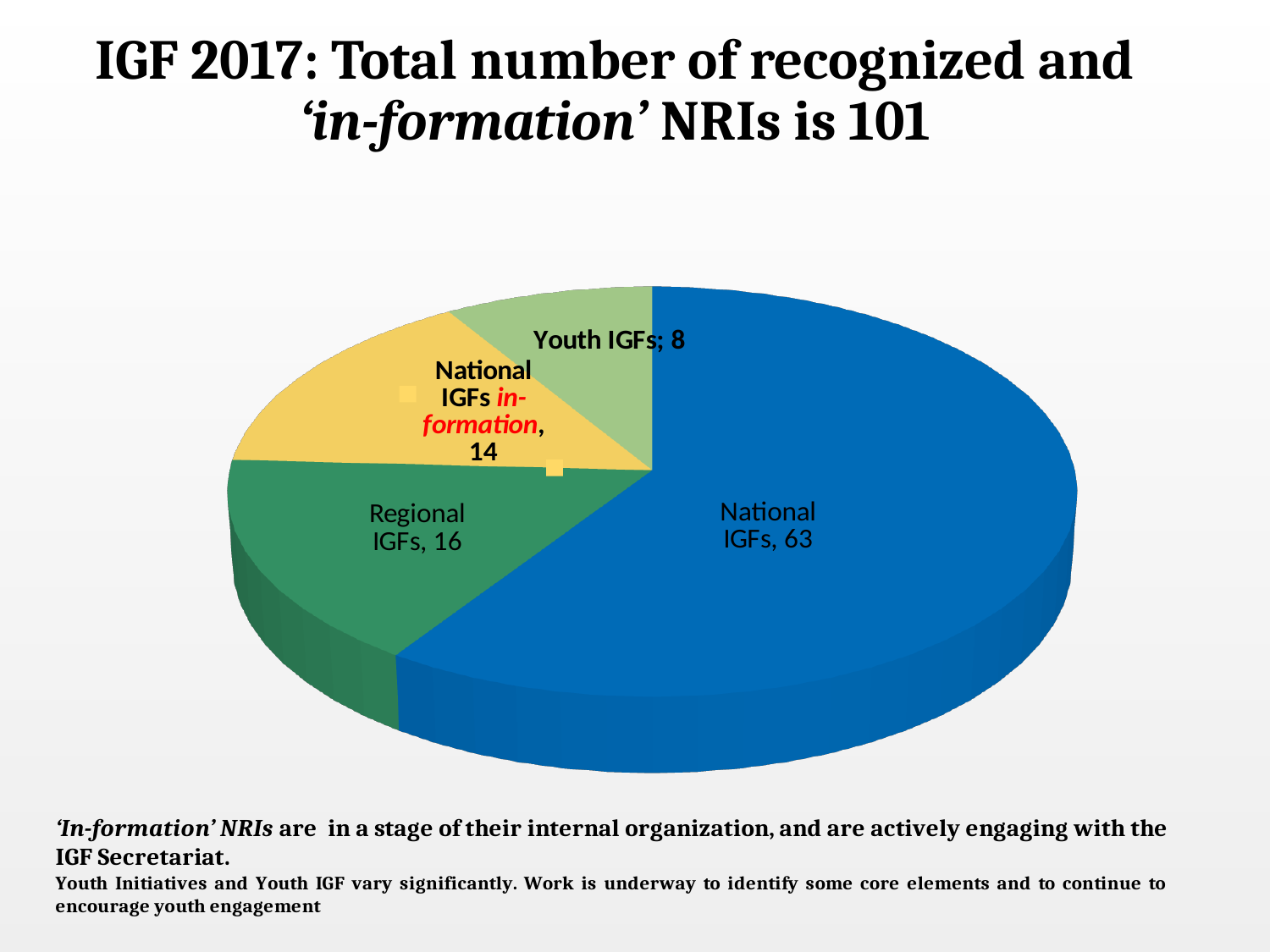
How many slices does the pie chart have? 4 What is the difference between the values for National IGFs and Regional IGFs? 47 What is the value for National IGFs? 63 Which category has the smallest slice of the pie? Youth IGFs What is the value for Regional IGFs? 16 What is the value for Youth IGFs? 8 Which category has the largest slice of the pie? National IGFs Which is larger, Regional IGFs or Youth IGFs? Regional IGFs What is the value for National IGFs in-formation? 14 What is the total of all the slices in the pie chart? 101 What colour is the National IGFs slice? Blue What kind of chart is shown on the slide? Pie chart